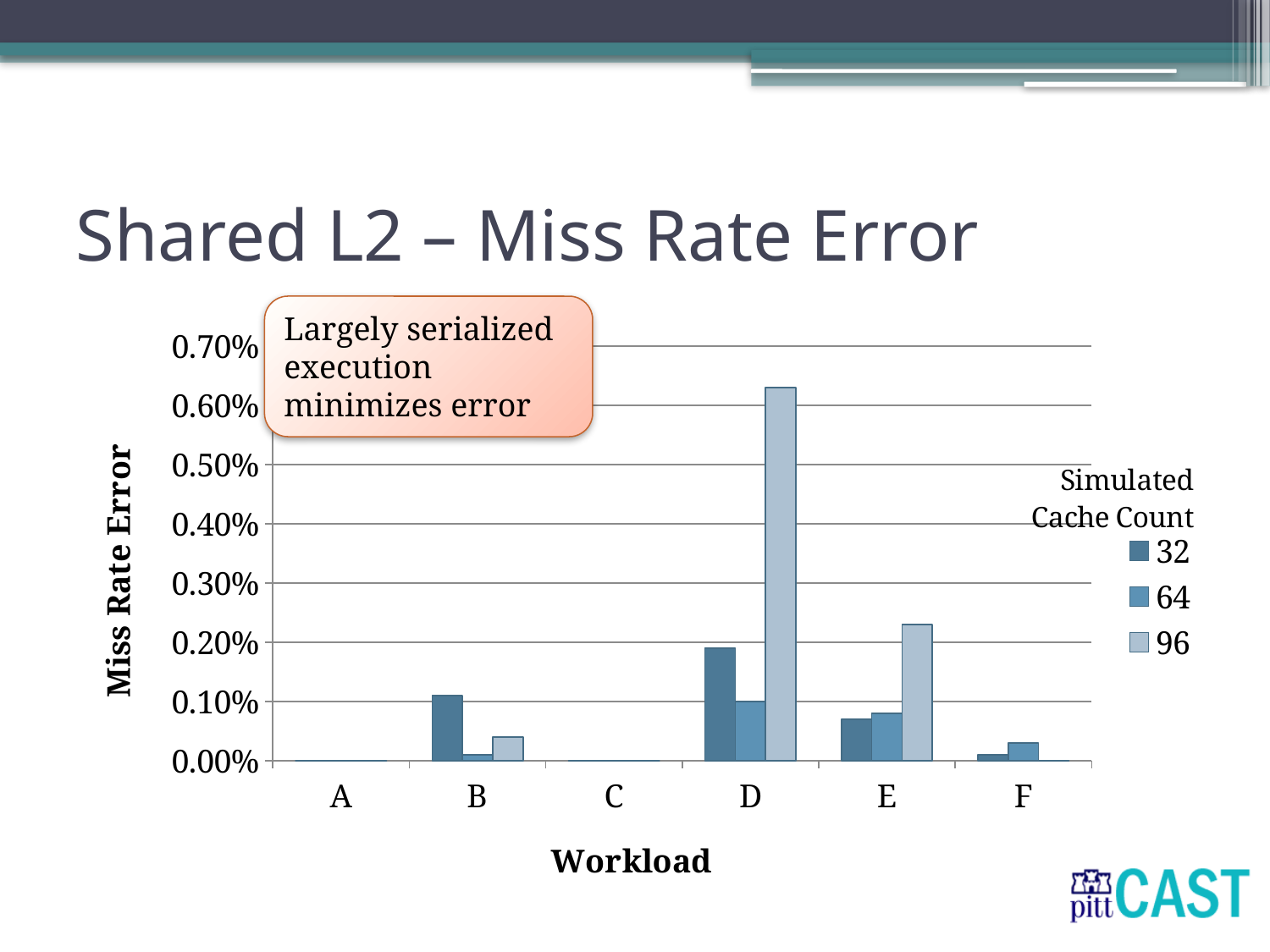
Which workload has the tallest bar in the chart? D How many workloads are shown on the x axis? 6 Which is larger: the 96-cache bar for workload D or the 96-cache bar for workload E? workload D Is the value for workload D with 32 simulated caches greater or less than 0.10%? greater For workload B, which is larger: the bar for 32 simulated caches or the bar for 96 simulated caches? 32 What kind of chart is shown on the slide? bar chart What is the title of the legend in the chart? Simulated Cache Count Is the value for workload D with 96 simulated caches greater or less than 0.50%? greater For workload D, which simulated cache count has the highest miss rate error? 96 Is the value for workload B with 32 simulated caches greater or less than 0.20%? less How many series does the legend list? 3